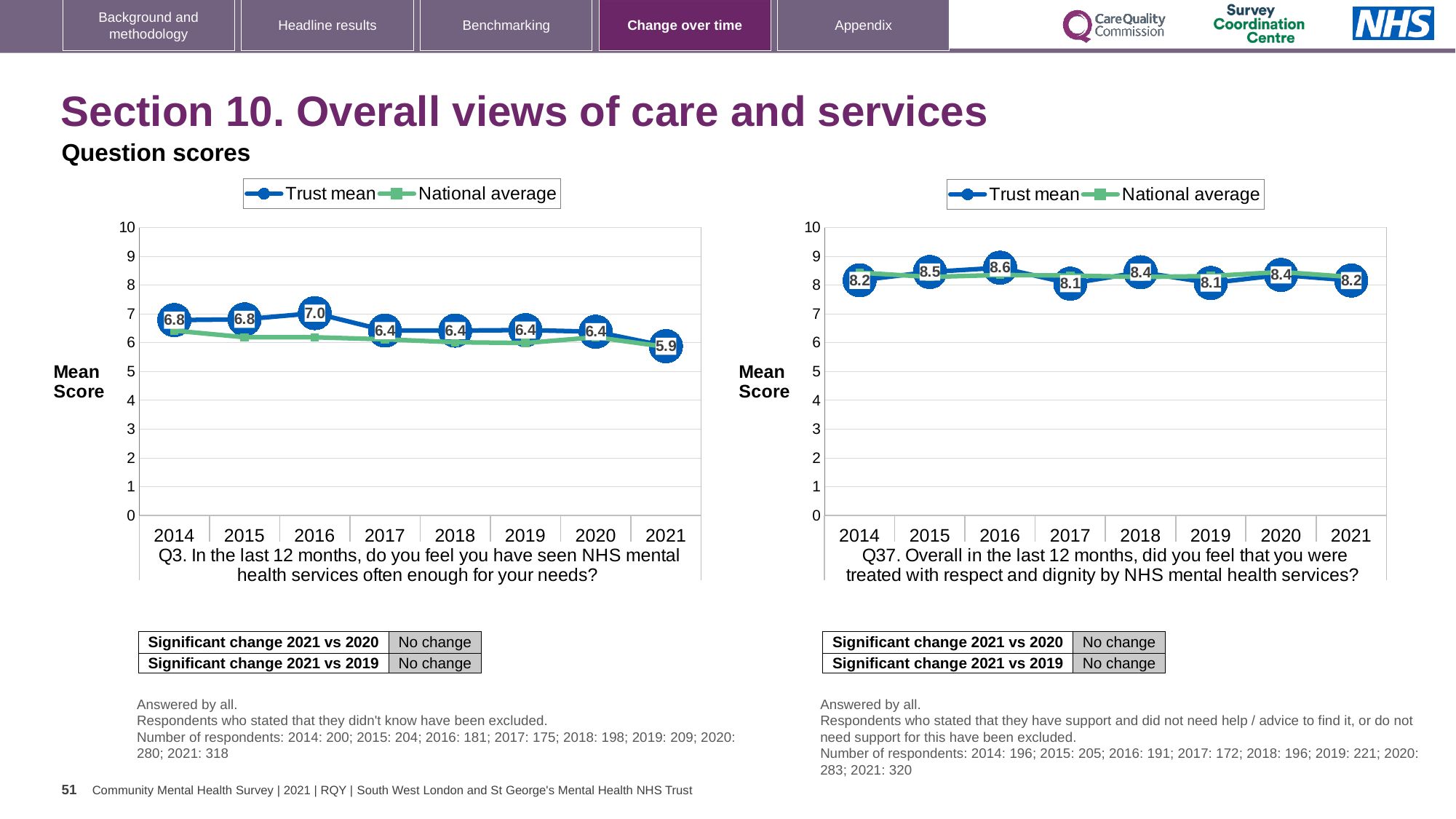
How many series does the legend of the Q37 chart (right) list? 2 On the Q3 chart (left), what is the Trust mean score for 2021? 5.9 On the Q37 chart (right), which year has the highest Trust mean score? 2016 On the Q37 chart (right), what is the Trust mean score for 2015? 8.5 On the Q3 chart (left), what is the Trust mean score for 2016? 7.0 On the Q37 chart (right), is the Trust mean score for 2014 greater or less than 8? greater How many years are plotted on the x axis of the Q3 chart (left)? 8 On the Q37 chart (right), what is the difference between the Trust mean scores for 2016 and 2017? 0.5 What type of chart is the Q3 chart (left)? Line chart On the Q3 chart (left), which year has the highest Trust mean score? 2016 On the Q3 chart (left), which year has the lowest Trust mean score? 2021 On the Q3 chart (left), what is the difference between the Trust mean scores for 2016 and 2021? 1.1